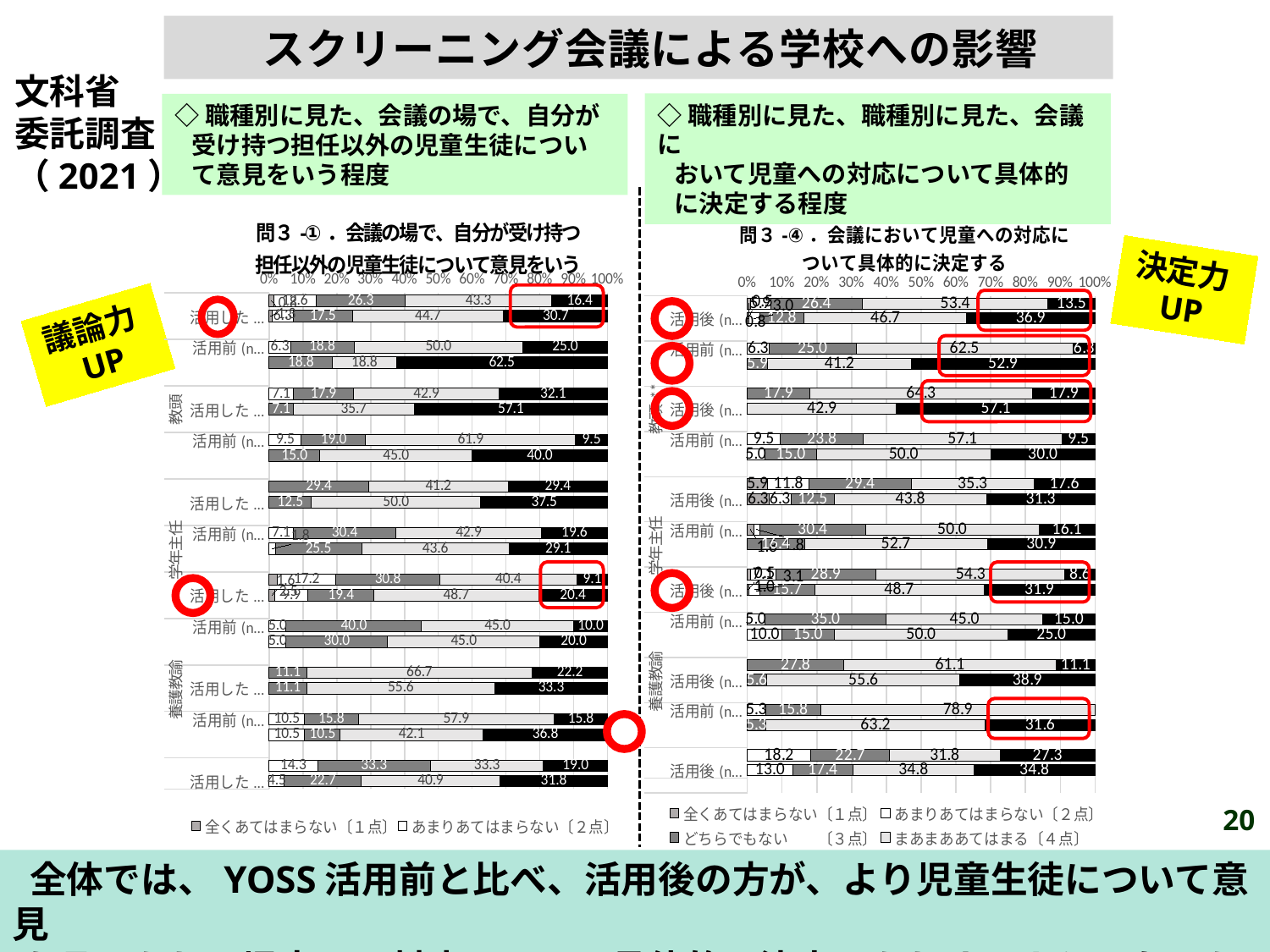
In the left chart (問3-①), in the 教頭 group, what is the value of the black segment in the second 活用した bar? 57.1 What is the title of the right chart on the slide? 問3-④. 会議において児童への対応について具体的に決定する What is the maximum value shown on the x axis of the right chart (問3-④)? 100% In the left chart (問3-①), what is the value of the black segment in the second bar from the top? 30.7 In the right chart (問3-④), in the 養護教諭 活用前 bars, which is larger: the 78.9 segment in the first bar or the 63.2 segment in the second bar? 78.9 In the right chart (問3-④), in the bottom group's first 活用後 bar, what is the difference between the 31.8 segment and the 27.3 segment? 4.5 In the left chart (問3-①), what is the value of the largest segment in the topmost bar? 43.3 What type of chart is used on the left side of the slide (問3-①)? Stacked horizontal bar chart In the right chart (問3-④), what is the value of the black segment in the bottommost bar? 34.8